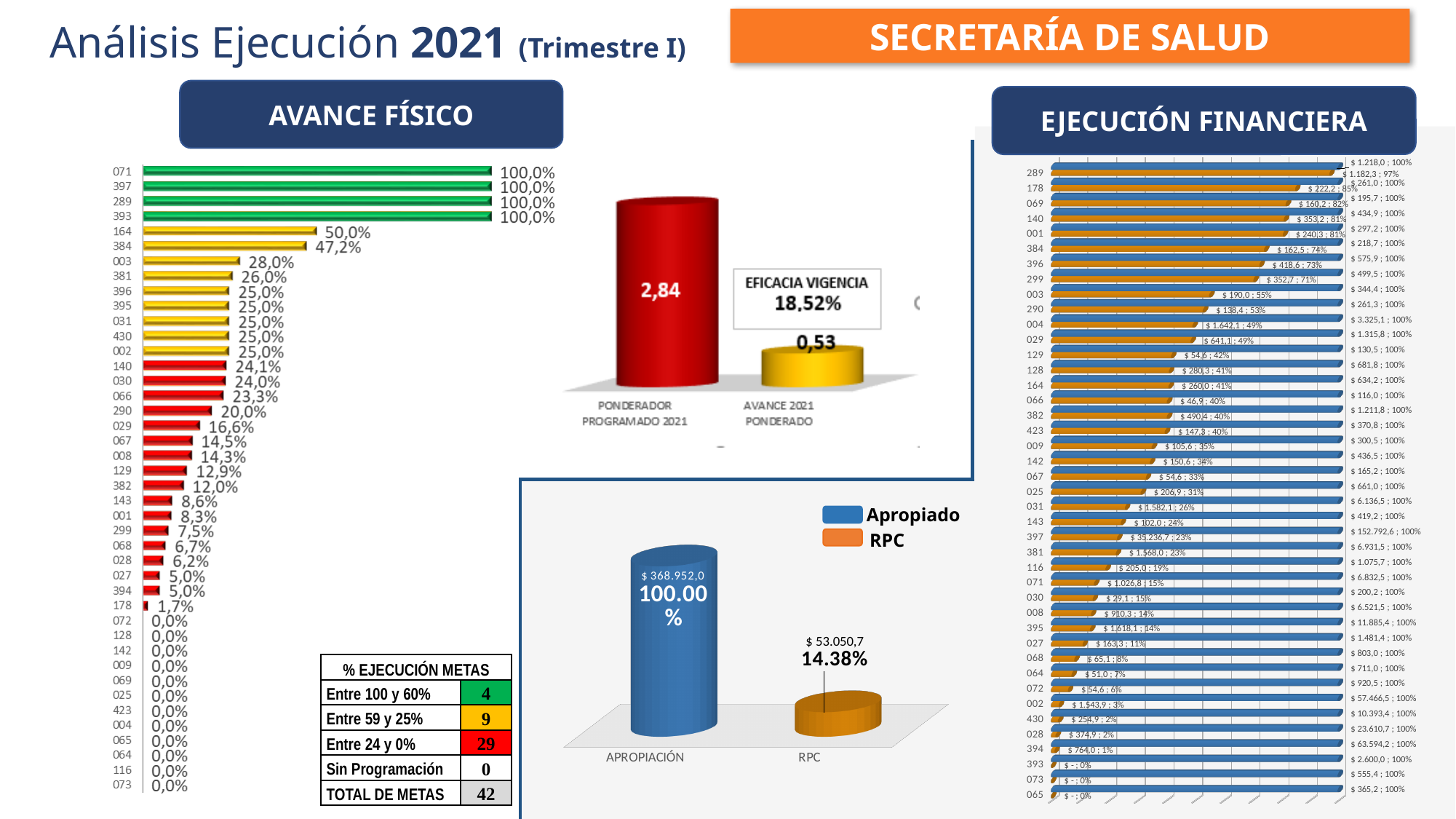
In the Avance Físico chart, what is the value for category 384? 47,2% What kind of chart is the Avance Físico chart? bar chart In the APROPIACIÓN / RPC chart, what amount is shown for RPC? $ 53.050,7 In the chart with PONDERADOR PROGRAMADO 2021 and AVANCE 2021 PONDERADO, what is the value for AVANCE 2021 PONDERADO? 0,53 In the Avance Físico chart, which is larger, the value for 140 or the value for 030? 140 In the Avance Físico chart, what is the difference between the values for 164 and 384? 2,8% How many categories are plotted in the Avance Físico chart? 42 In the chart with PONDERADOR PROGRAMADO 2021 and AVANCE 2021 PONDERADO, what is the value for PONDERADOR PROGRAMADO 2021? 2,84 In the Avance Físico chart, what is the value for category 164? 50,0% In the Avance Físico chart, what is the value for category 178? 1,7% In the APROPIACIÓN / RPC chart, what percentage is shown for RPC? 14.38%